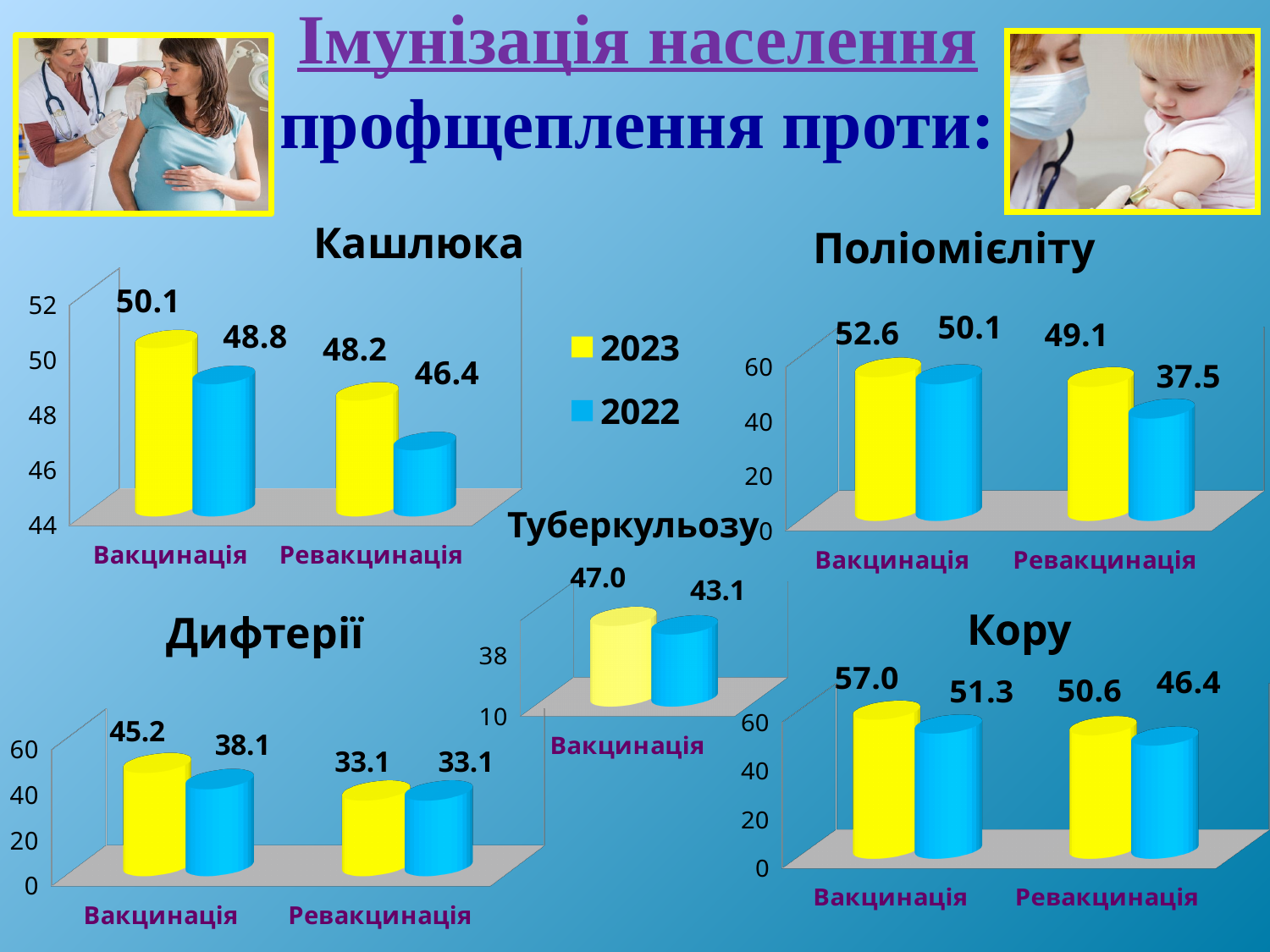
What kind of chart is the 'Кору' chart? Bar chart In the 'Дифтерії' chart, which is larger for Ревакцинація: the 2023 value or the 2022 value? They are equal (33.1) In the 'Поліомієліту' chart, which bar has the highest value? Вакцинація 2023 (52.6) Which colour represents the 2023 series in the legend? Yellow In the 'Кашлюка' chart, what is the value for Вакцинація in 2023? 50.1 In the 'Кору' chart, what is the difference between the 2023 and 2022 values for Вакцинація? 5.7 How many categories are shown on the x axis of the 'Дифтерії' chart? 2 In the 'Кашлюка' chart, which bar has the lowest value? Ревакцинація 2022 (46.4) In the 'Поліомієліту' chart, what is the value for Ревакцинація in 2022? 37.5 How many series does the legend list? 2 In the 'Поліомієліту' chart, what is the difference between the 2023 and 2022 values for Ревакцинація? 11.6 In the 'Туберкульозу' chart, what is the value for Вакцинація in 2022? 43.1